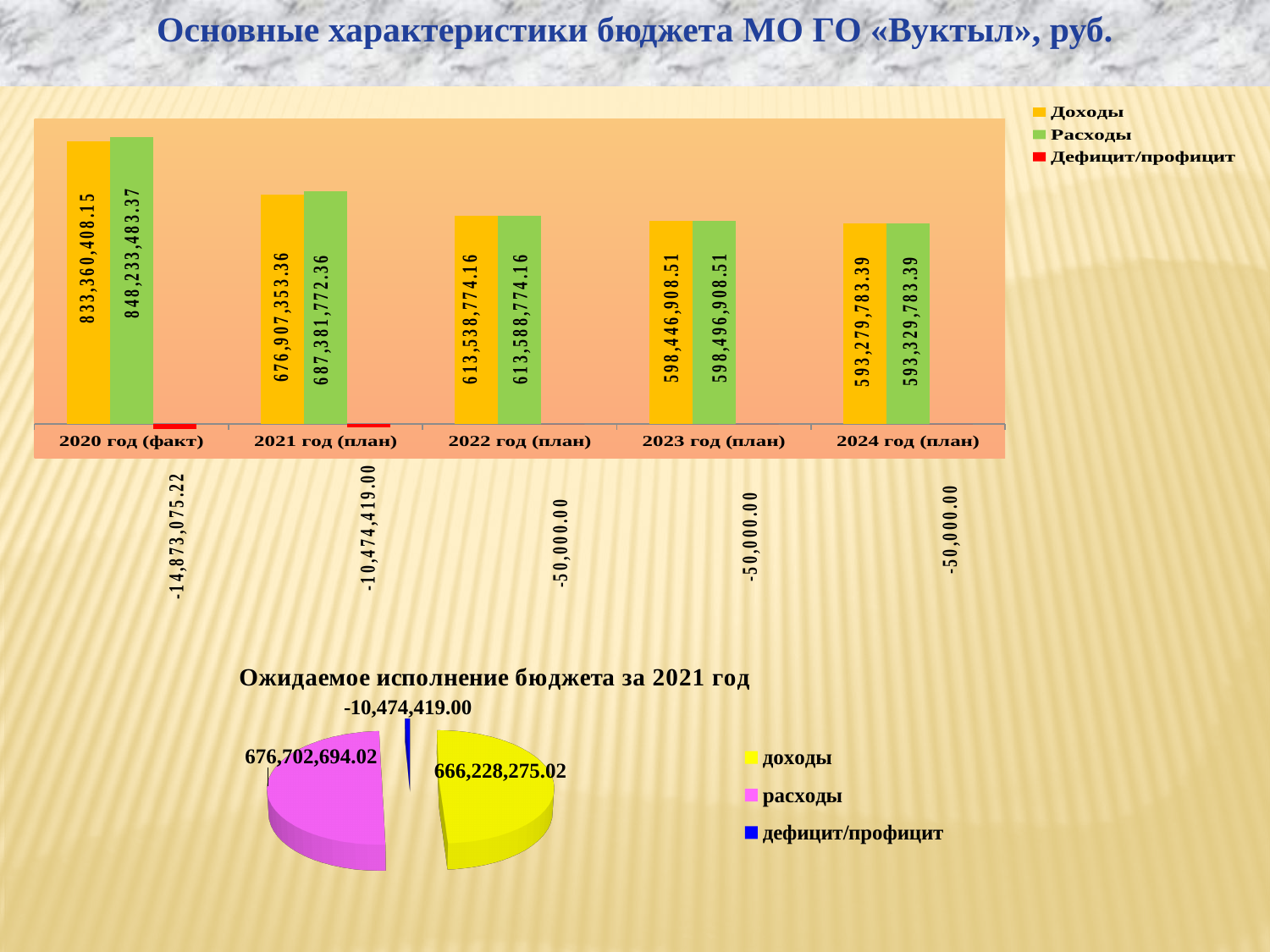
In the top bar chart, which year has the lowest Расходы value? 2024 год (план) In the top bar chart, how many series does the legend list? 3 In the top bar chart, what is the Дефицит/профицит value for 2023 год (план)? -50,000.00 In the top bar chart, what is the difference between Расходы and Доходы for 2020 год (факт)? 14,873,075.22 In the top bar chart, what is the value of Расходы for 2021 год (план)? 687,381,772.36 In the top bar chart, which year has the highest Доходы value? 2020 год (факт) What kind of chart is the bottom chart titled 'Ожидаемое исполнение бюджета за 2021 год'? pie chart In the top bar chart, which is larger for 2022 год (план): Доходы or Расходы? Расходы In the bottom pie chart, what is the value of расходы? 676,702,694.02 In the top bar chart, how many year categories are shown on the x axis? 5 In the top bar chart, do the Доходы values rise or fall from 2020 год (факт) to 2024 год (план)? fall In the top bar chart, what is the value of Доходы for 2020 год (факт)? 833,360,408.15